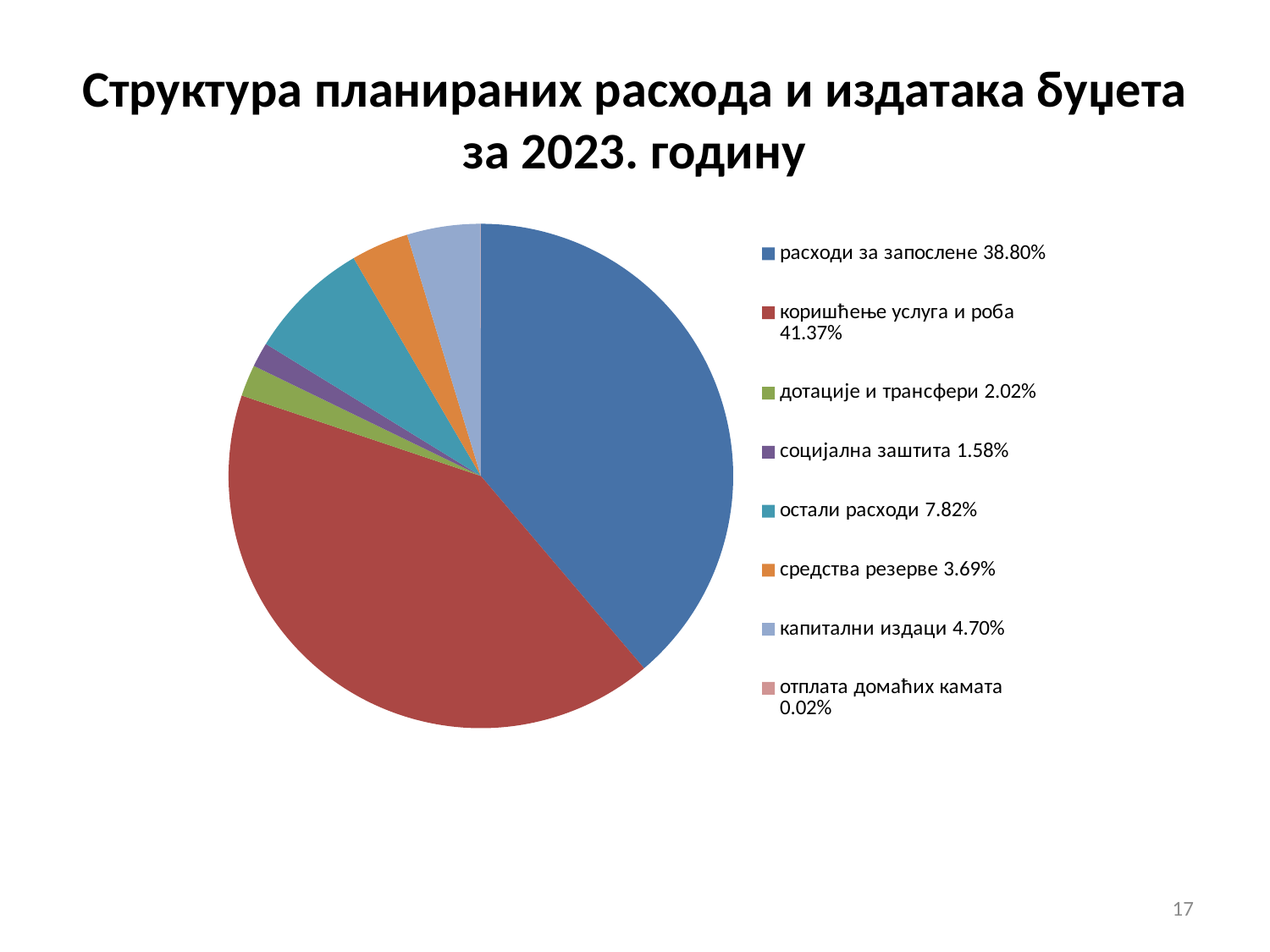
What is the share for капитални издаци? 4.70% What is the share for коришћење услуга и роба? 41.37% What is the title of the chart slide? Структура планираних расхода и издатака буџета за 2023. годину What is the share for остали расходи? 7.82% Which category has the smallest share of the pie? отплата домаћих камата Which category has the largest share of the pie? коришћење услуга и роба What is the share for расходи за запослене? 38.80% How many categories does the legend list? 8 What is the difference in percentage points between коришћење услуга и роба and расходи за запослене? 2.57 What is the share for отплата домаћих камата? 0.02% What kind of chart is shown on the slide? pie chart Which is larger, the share for остали расходи or the share for капитални издаци? остали расходи